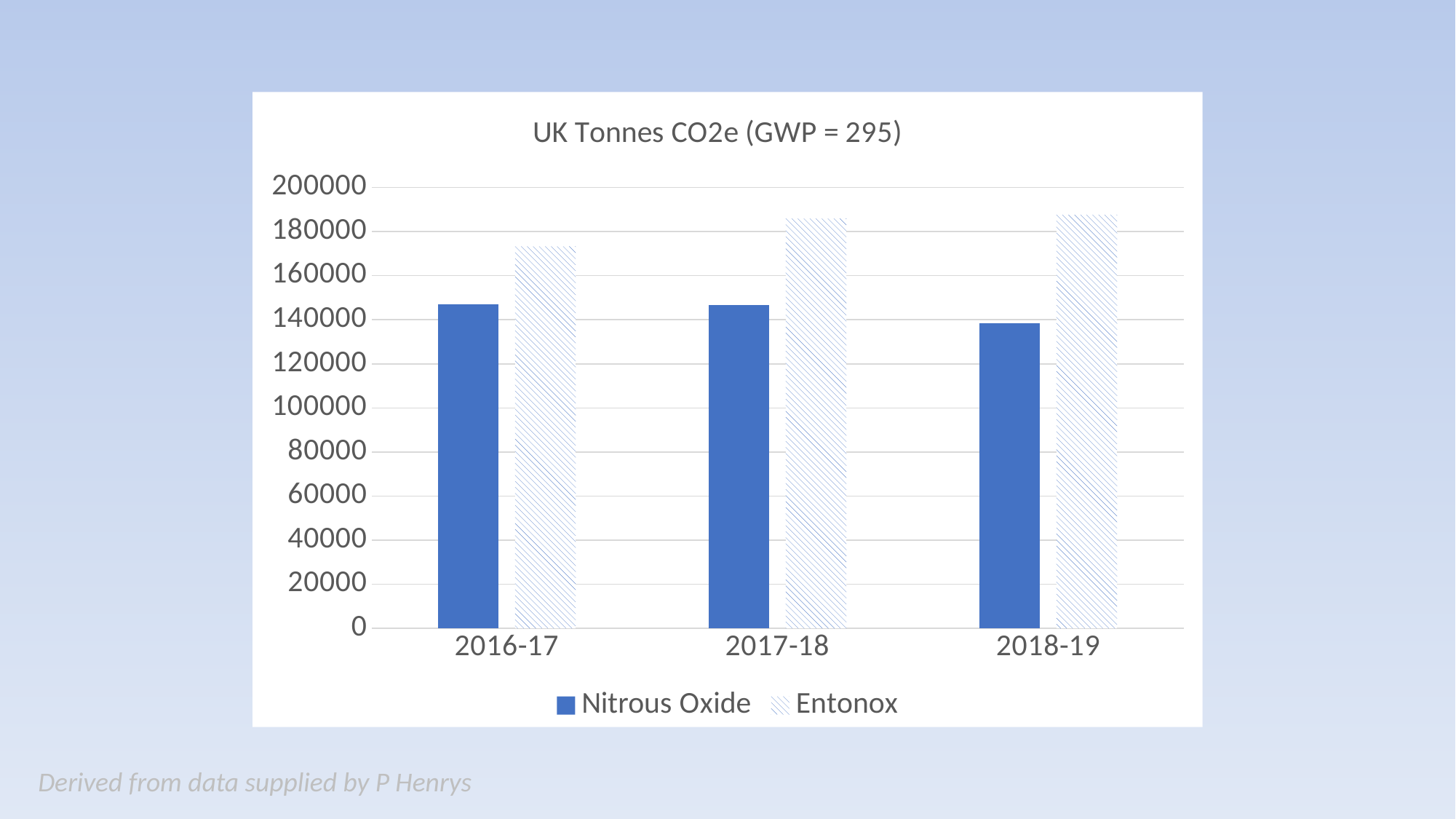
Is the Entonox value for 2016-17 greater or less than 180000? less Is the Nitrous Oxide value for 2018-19 greater or less than 160000? less Is the Nitrous Oxide value for 2016-17 greater or less than 140000? greater What type of chart is shown on the slide? bar chart How many series does the legend list? 2 Which series is shown with a hatched (diagonal line) pattern? Entonox What is the title of the chart? UK Tonnes CO2e (GWP = 295) How many year categories are shown on the x axis? 3 In 2018-19, which is larger: Nitrous Oxide or Entonox? Entonox Do the Entonox values rise or fall from 2016-17 to 2018-19? rise In which year is the Entonox value lowest? 2016-17